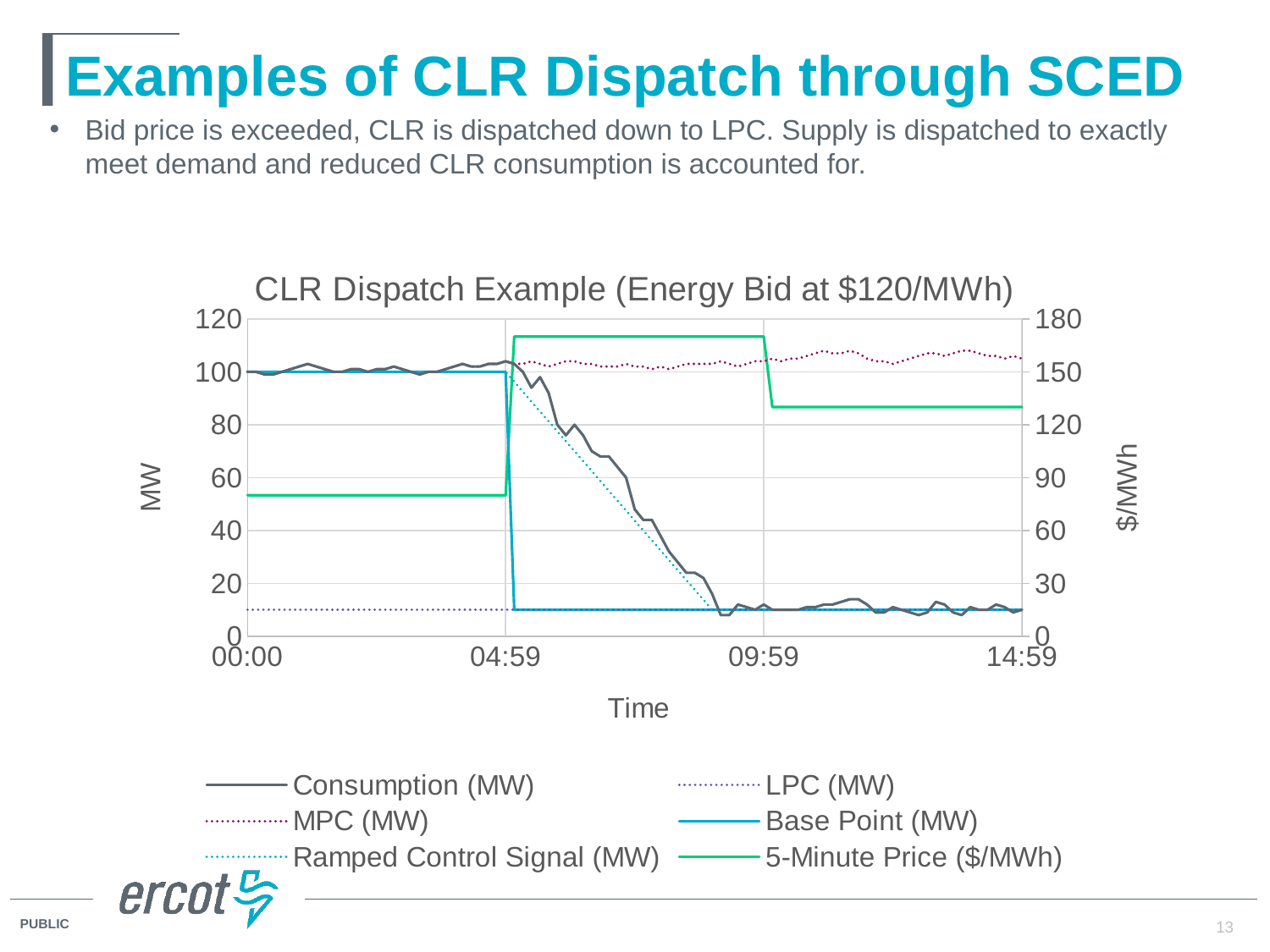
Is the 5-Minute Price ($/MWh) between 04:59 and 09:59 greater or less than 150? greater Which is larger, Consumption (MW) at 00:00 or Consumption (MW) at 14:59? Consumption at 00:00 Is the 5-Minute Price ($/MWh) after 09:59 greater or less than 120? greater How many series does the chart's legend list? 6 Is the Consumption (MW) value at 14:59 greater or less than 20? less What is the title of the chart? CLR Dispatch Example (Energy Bid at $120/MWh) Does Consumption (MW) rise or fall between 04:59 and 09:59? fall What kind of chart is shown on the slide? line chart What is the Base Point (MW) value at 00:00? 100 What is the label of the right-hand vertical axis? $/MWh In which time interval is the 5-Minute Price ($/MWh) highest: before 04:59, between 04:59 and 09:59, or after 09:59? between 04:59 and 09:59